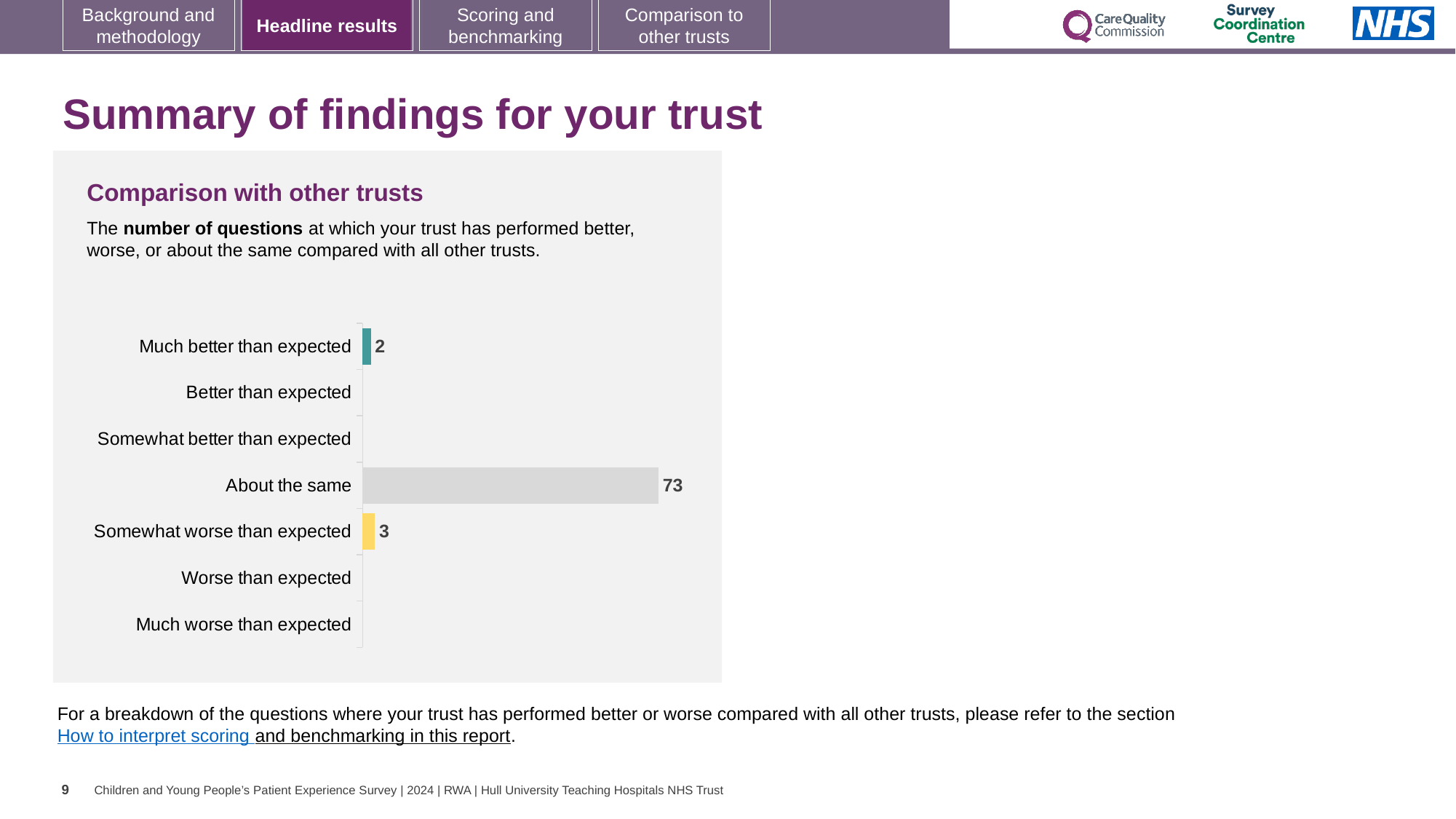
Which is larger: the value for 'Much better than expected' or the value for 'Somewhat worse than expected'? Somewhat worse than expected What is the value for 'Much better than expected'? 2 How many categories are listed on the chart's axis? 7 Which category has the highest number of questions? About the same What kind of chart is shown on the slide? Bar chart What is the value for 'Somewhat worse than expected'? 3 What is the difference between the 'Somewhat worse than expected' value and the 'Much better than expected' value? 1 What colour is the bar for 'Somewhat worse than expected'? Yellow How many categories have a visible bar with a data label? 3 What is the title of the chart? Comparison with other trusts What is the difference between the 'About the same' value and the 'Somewhat worse than expected' value? 70 How many questions are in the 'About the same' category? 73